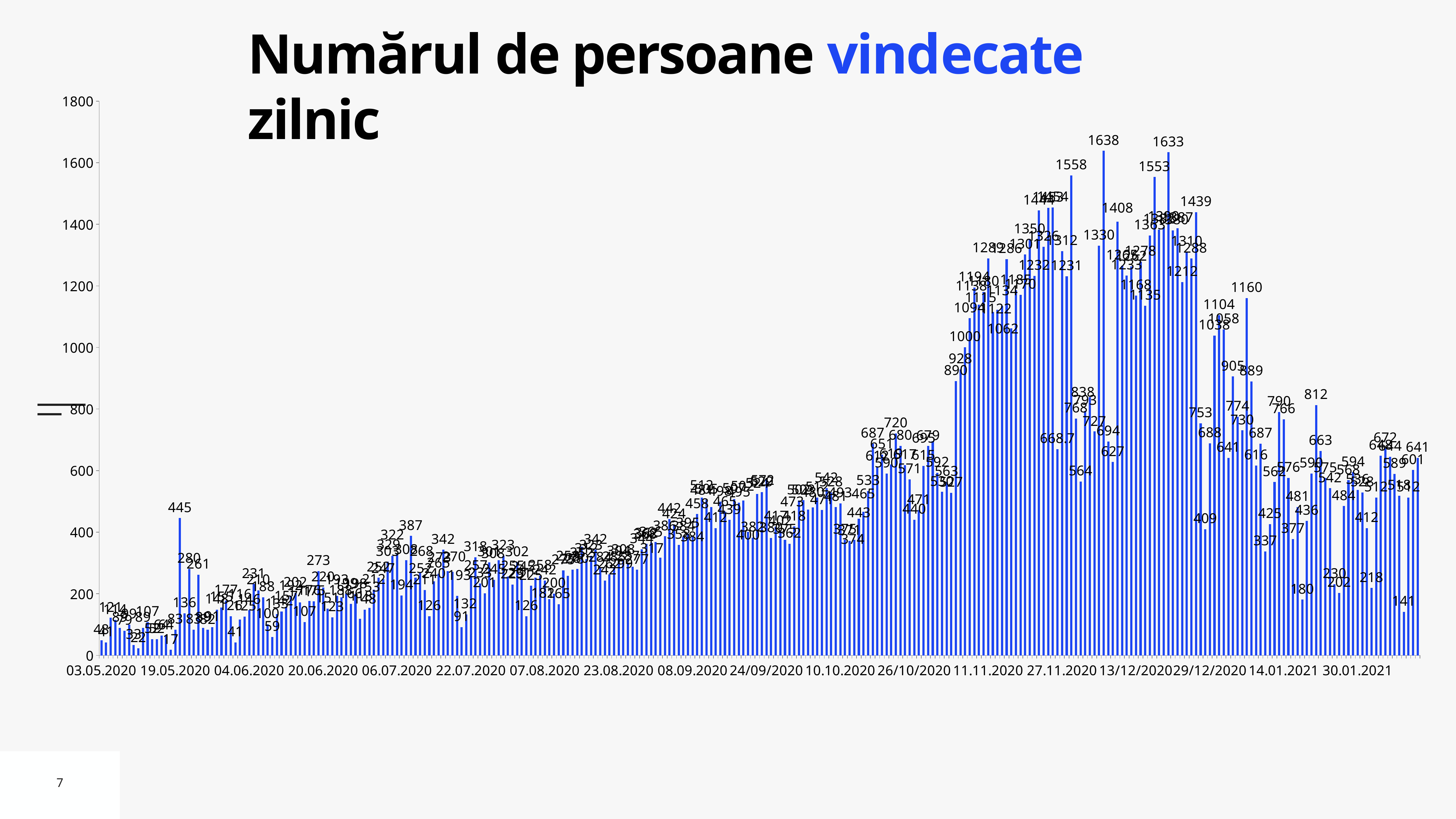
What is the difference between the peak labeled 445 and the peak labeled 387? 58 Do the values generally rise or fall from 03.05.2020 to 27.11.2020? rise Is the value of the first bar at 03.05.2020 greater or less than 200? less What kind of chart is shown on the slide? bar chart Is the tallest bar near 13/12/2020 greater or less than 1600? greater What is the maximum value shown on the vertical axis? 1800 What is the title of the chart on the slide? Numărul de persoane vindecate zilnic What is the highest value labeled on the chart? 1638 What is the lowest value labeled on the chart? 17 What is the value of the tallest bar in the second half of December 2020, labeled near 29/12/2020? 1633 Which is larger: the peak labeled 445 in May 2020 or the peak labeled 387 in July 2020? 445